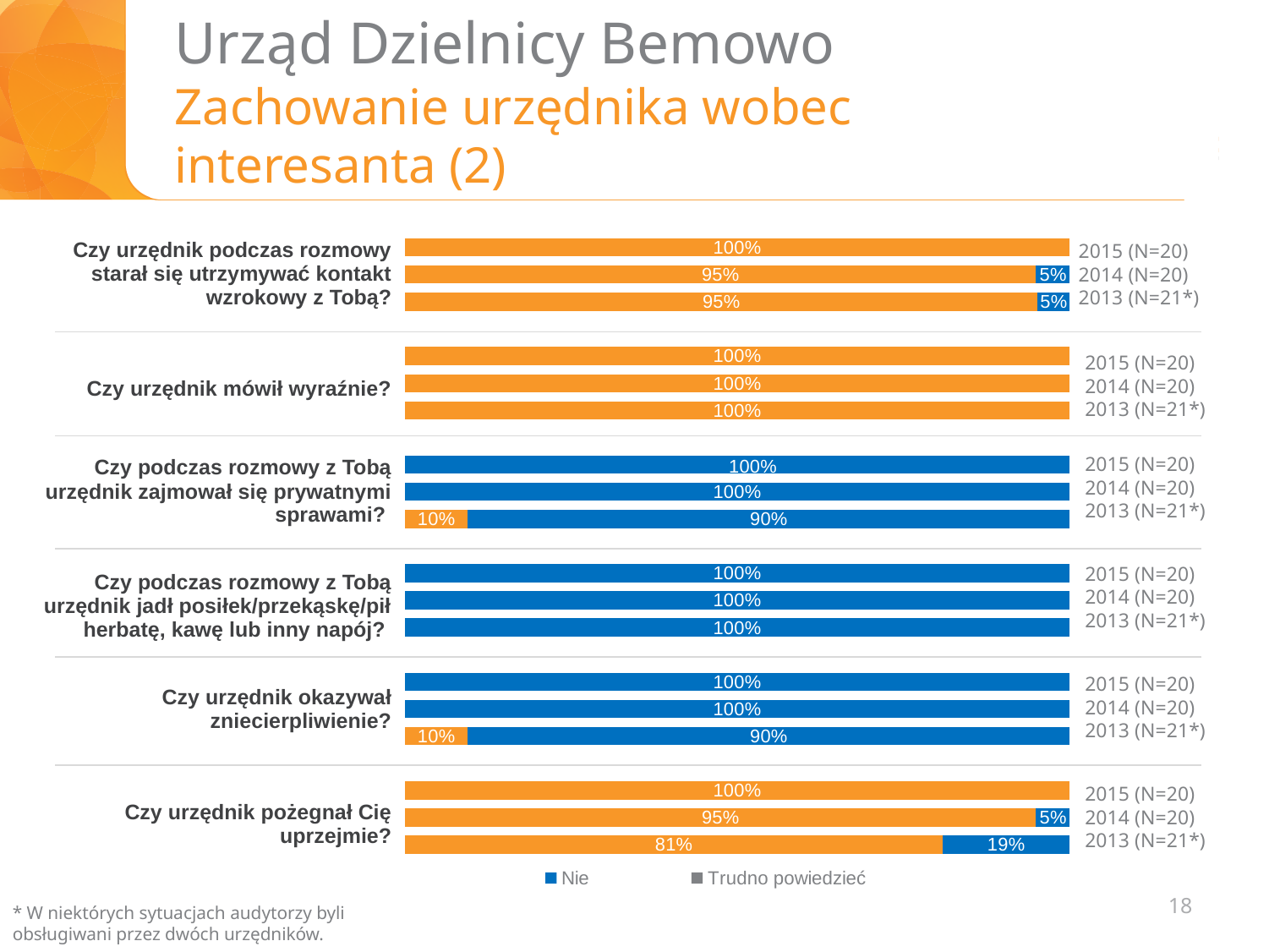
What is the value shown for 2015 (N=20) in the row "Czy urzędnik mówił wyraźnie?"? 100% How many years (bars) are shown for each survey question? 3 In the row "Czy urzędnik pożegnał Cię uprzejmie?", what is the difference between the orange segment for 2014 (95%) and for 2013 (81%)? 14 percentage points What is the value of the orange segment for 2014 (N=20) in the row "Czy urzędnik podczas rozmowy starał się utrzymywać kontakt wzrokowy z Tobą?"? 95% What kind of chart is shown on the slide? Stacked horizontal bar chart What is the value of the larger segment for 2013 (N=21*) in the row "Czy urzędnik pożegnał Cię uprzejmie?"? 81% In the row "Czy urzędnik pożegnał Cię uprzejmie?", which year has the larger orange segment: 2014 or 2013? 2014 How many survey questions (row groups) are shown in the chart? 6 What sample size (N) is given for 2013 in the chart? N=21* What is the value of the smaller (blue) segment for 2013 (N=21*) in the row "Czy urzędnik pożegnał Cię uprzejmie?"? 19% In the row "Czy urzędnik pożegnał Cię uprzejmie?", what is the total of the 2013 (N=21*) bar (81% + 19%)? 100% What is the value of the blue segment for 2013 (N=21*) in the row "Czy urzędnik okazywał zniecierpliwienie?"? 90%